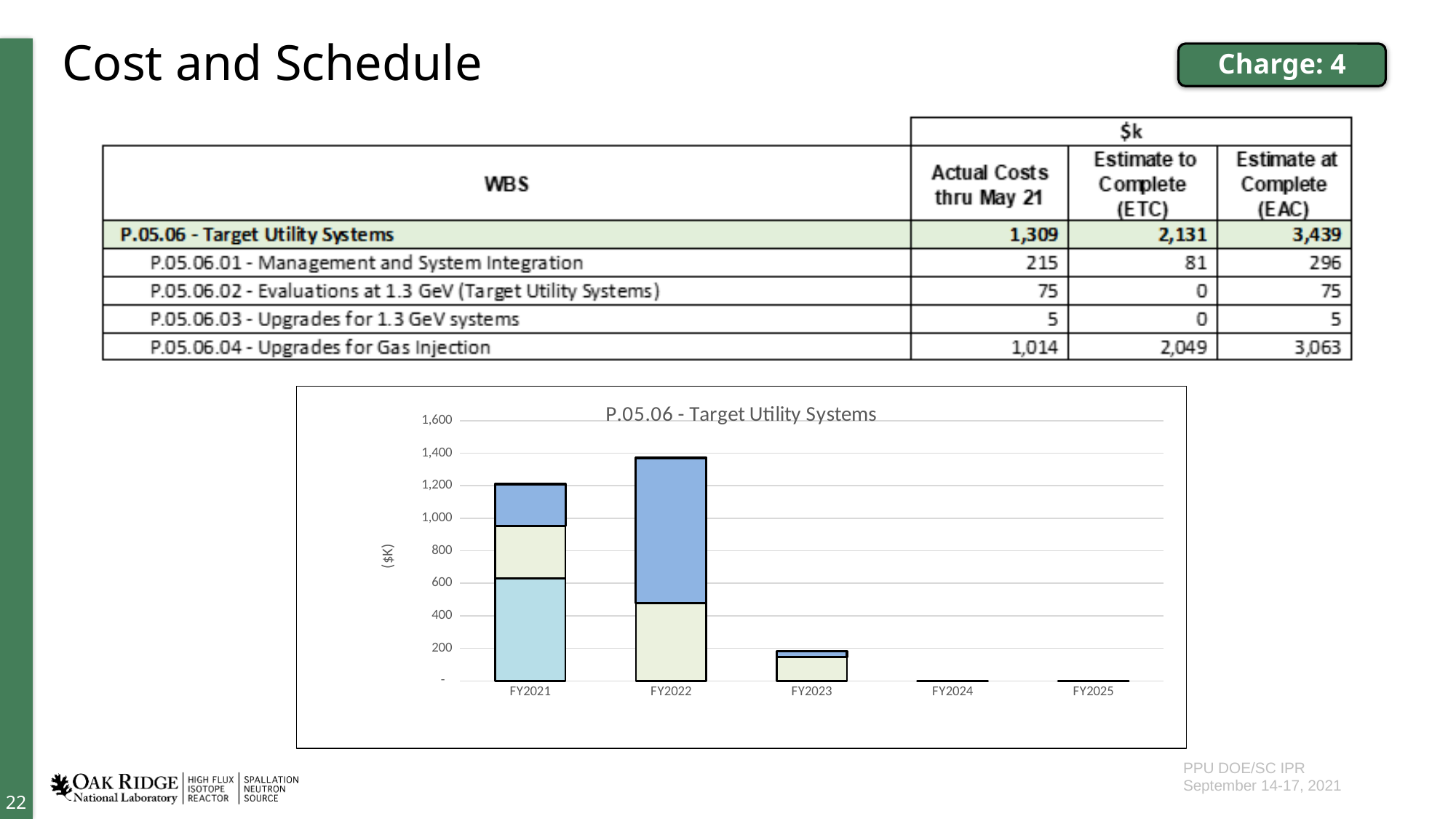
What is the label on the chart's vertical axis? ($K) Which fiscal year has the tallest bar in the chart? FY2022 Do the bar heights rise or fall from FY2022 to FY2025? fall What is the title of the chart? P.05.06 - Target Utility Systems How many fiscal years are shown on the x axis of the chart? 5 Which bar is taller, FY2021 or FY2023? FY2021 Is the total bar height for FY2024 greater or less than 200? less Is the total bar height for FY2022 greater or less than 1,400? less Is the total bar height for FY2021 greater or less than 1,000? greater What kind of chart is shown on the slide? stacked bar chart